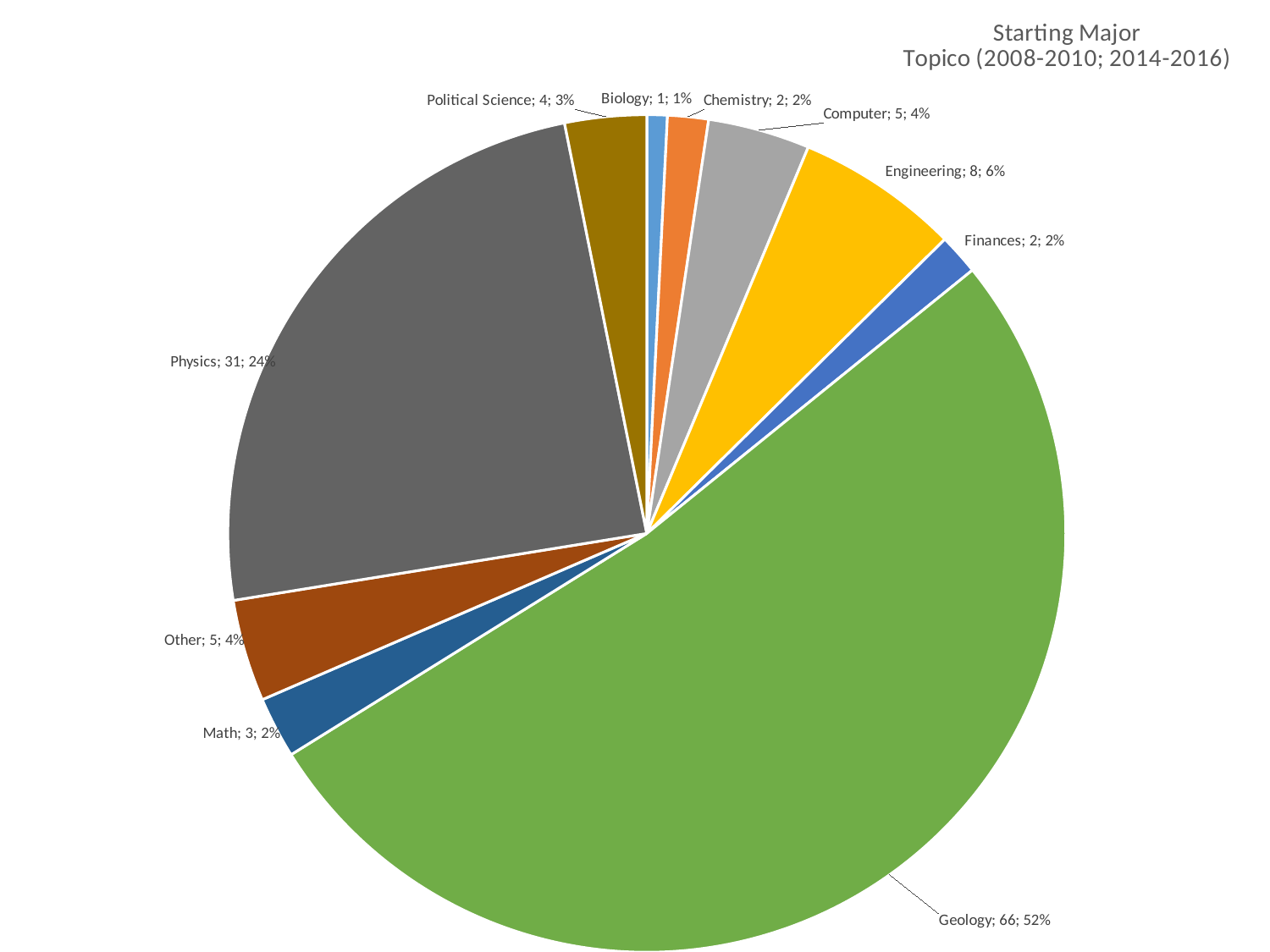
Which major has the smallest slice? Biology Which major has the largest slice? Geology What percentage share does Geology have? 52% What is the value shown for Geology? 66 What is the value shown for Engineering? 8 What is the value shown for Political Science? 4 What percentage share does Physics have? 24% Which is larger, the value for Computer or the value for Math? Computer How many slices does the pie chart have? 10 What is the title of the chart? Starting Major Topico (2008-2010; 2014-2016) What is the difference between the values for Geology and Physics? 35 What kind of chart is shown on the slide? pie chart